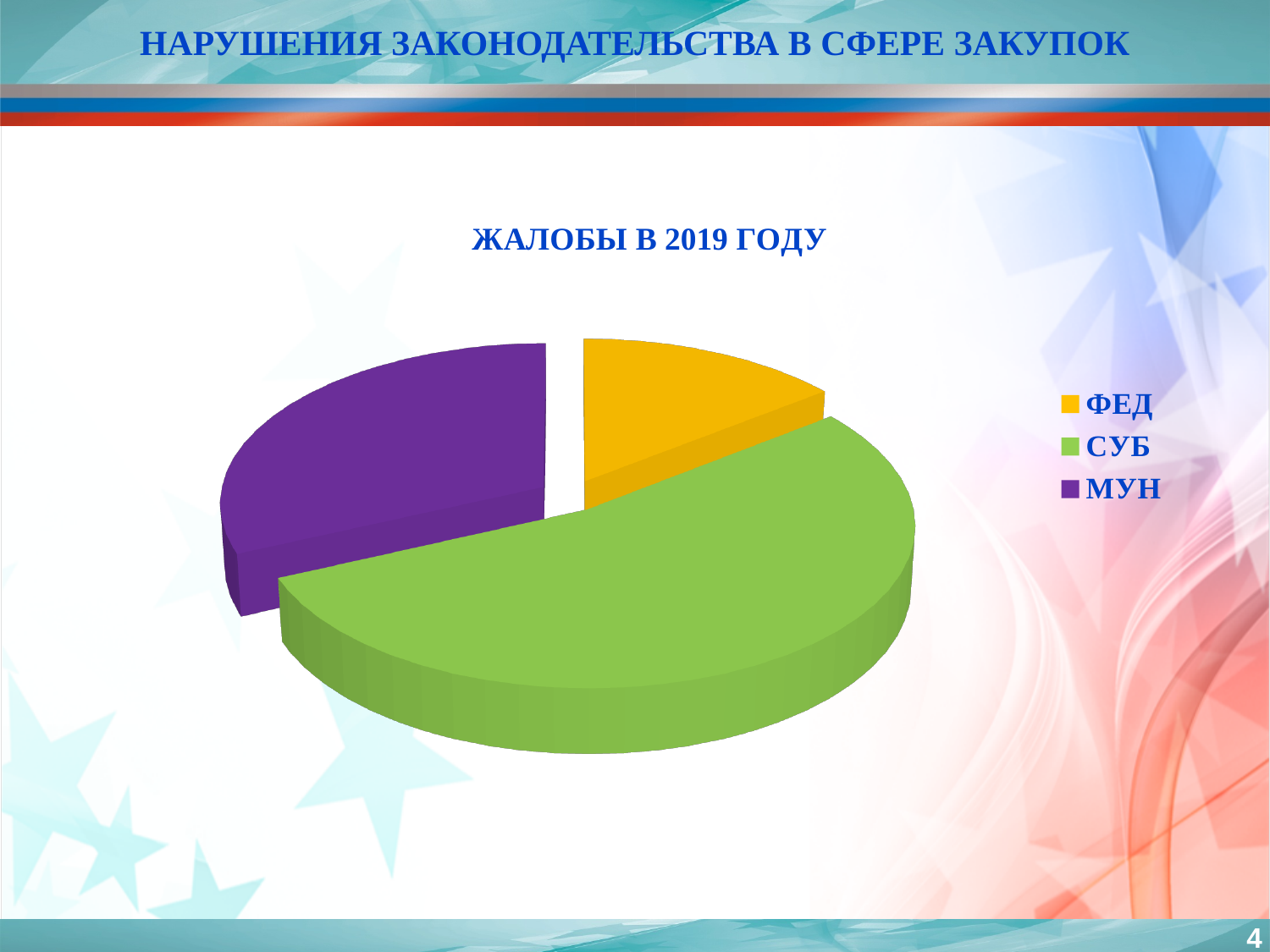
How many slices does the pie chart have? 3 Which slice is larger, СУБ or МУН? СУБ Which category has the smallest slice of the pie? ФЕД Which slice is larger, ФЕД or СУБ? СУБ Which category has the largest slice of the pie? СУБ How many entries does the legend list? 3 Which slice is larger, МУН or ФЕД? МУН What is the title of the chart? ЖАЛОБЫ В 2019 ГОДУ What kind of chart is shown on the slide? pie chart What colour is the slice for СУБ? green